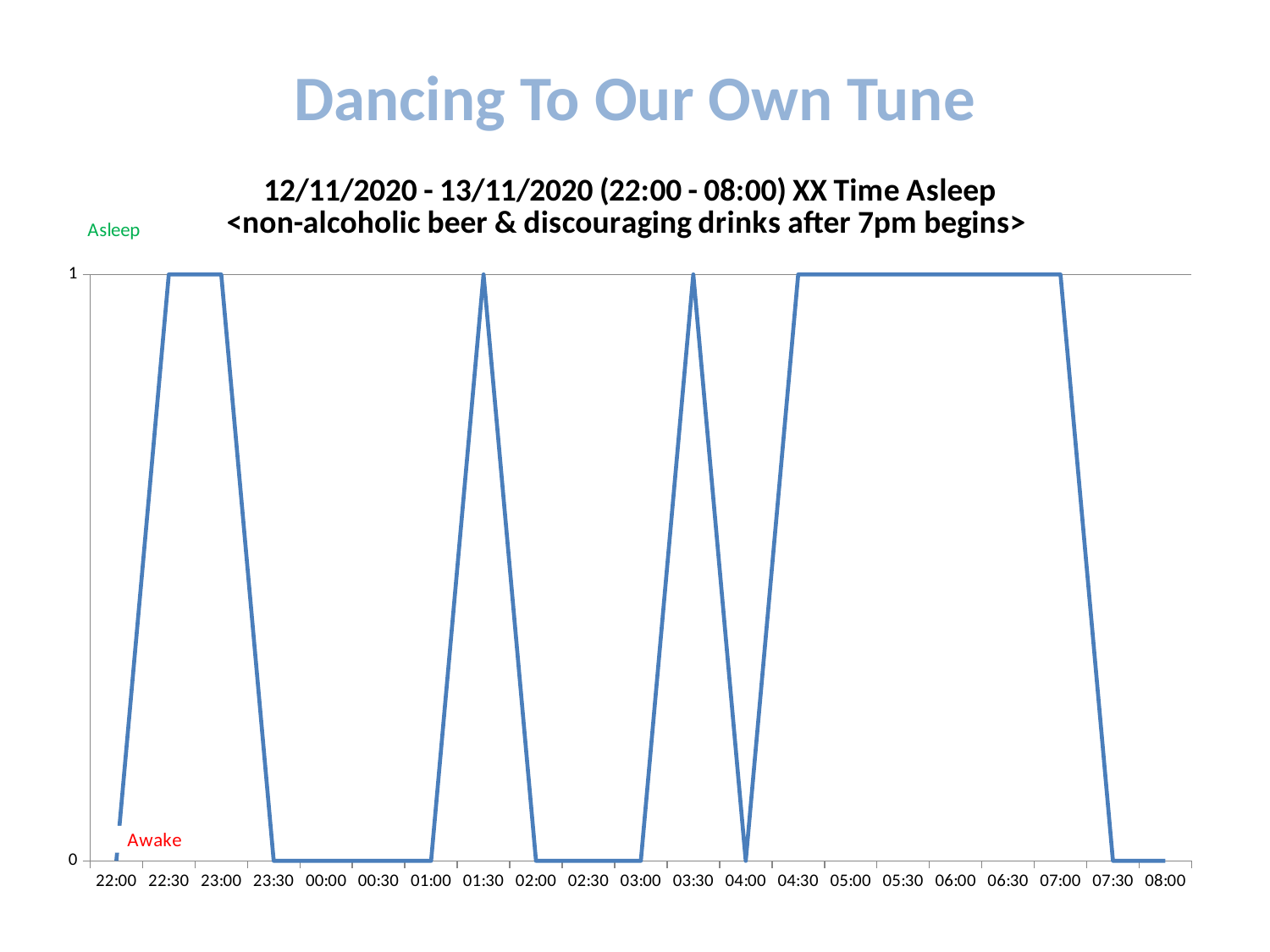
What is the value at 04:00? 0 What is the value at 06:00? 1 What kind of chart is shown on the slide? line chart Which is larger, the value at 23:00 or the value at 23:30? 23:00 What is the difference between the value at 05:00 and the value at 07:30? 1 What is the value at 01:30? 1 What is the value at 00:00? 0 What is the value at 22:30? 1 What is the value at 08:00? 0 What label is shown in red near the bottom of the y axis? Awake Does the value rise or fall between 07:00 and 07:30? fall How many time points are labelled on the x axis? 21